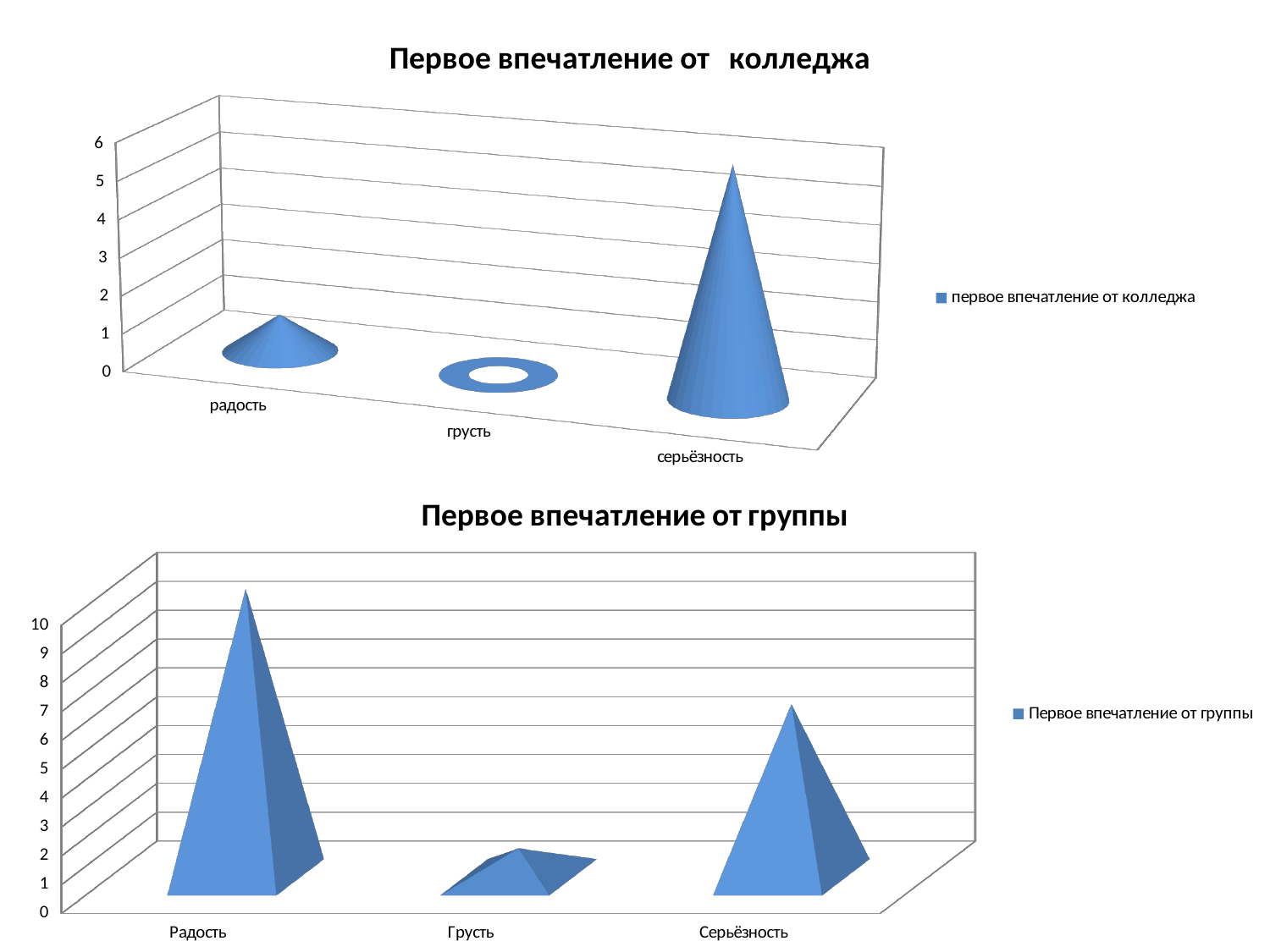
In the chart titled 'Первое впечатление от группы', is the value for Радость greater or less than 5? greater In the chart titled 'Первое впечатление от колледжа', which category has the highest value? серьёзность In the chart titled 'Первое впечатление от группы', which category has the highest value? Радость In the chart titled 'Первое впечатление от группы', which category has the lowest value? Грусть In the chart titled 'Первое впечатление от группы', is the value for Грусть greater or less than 5? less In the chart titled 'Первое впечатление от группы', which is larger, the value for Серьёзность or the value for Грусть? Серьёзность In the chart titled 'Первое впечатление от колледжа', which category has the lowest value? грусть What is the title of the top chart on the slide? Первое впечатление от колледжа In the chart titled 'Первое впечатление от колледжа', is the value for серьёзность greater or less than 3? greater How many series does the legend of the chart titled 'Первое впечатление от группы' list? 1 In the chart titled 'Первое впечатление от колледжа', how many categories are shown on the x axis? 3